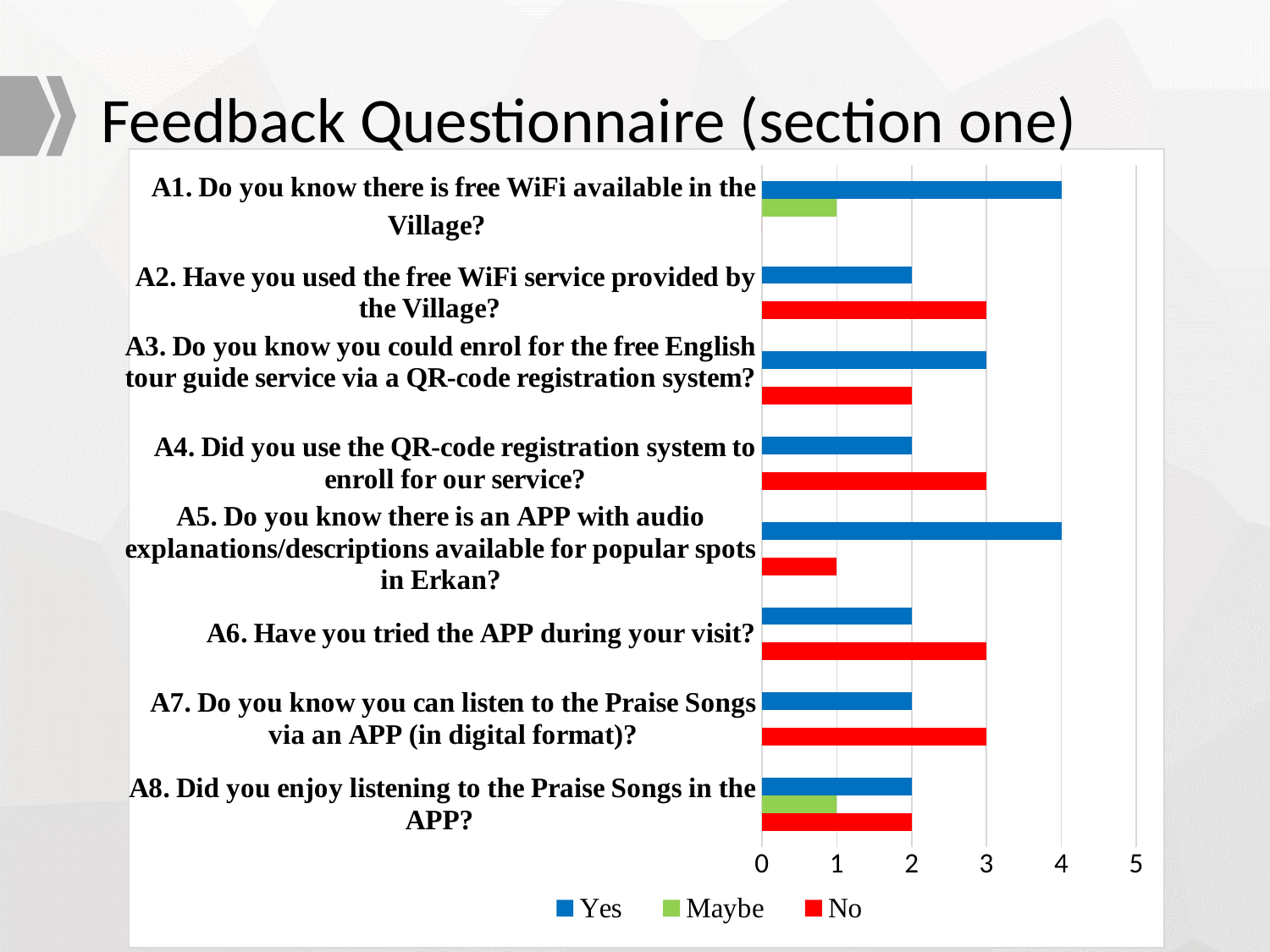
How many questions (categories) are shown on the chart? 8 Which colour represents the Maybe series in the legend? green Which question has the highest Yes value, A3 or A5? A5 What kind of chart is shown on the slide? bar chart What is the Maybe value for A8 (Did you enjoy listening to the Praise Songs in the APP?)? 1 Is the Yes value for A3 greater or less than 2? greater How many series does the legend list? 3 What is the No value for A2 (Have you used the free WiFi service provided by the Village?)? 3 What is the No value for A5 (Do you know there is an APP with audio explanations/descriptions available for popular spots in Erkan?)? 1 What is the Yes value for A1 (Do you know there is free WiFi available in the Village?)? 4 What is the difference between the No value and the Yes value for A4? 1 Which question has the lowest No value among those with a No bar? A5